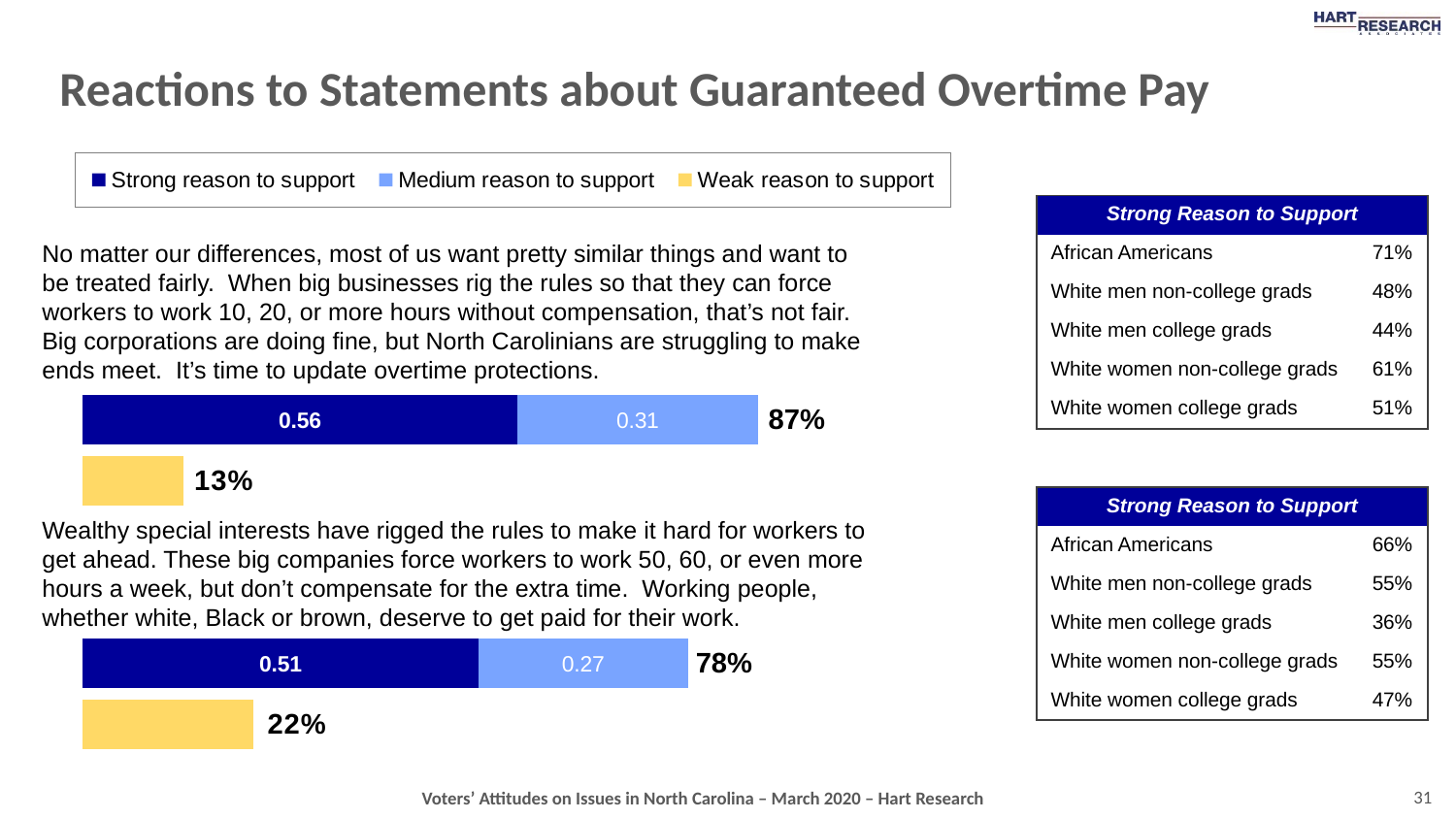
In the upper bar chart (first statement), what total percentage is printed at the end of the stacked strong/medium bar? 87% In the upper bar chart (first statement), what value is printed on the light blue 'Medium reason to support' segment? 0.31 How many series does the legend at the top of the slide list? 3 In the lower bar chart (second statement), what value is printed on the dark blue 'Strong reason to support' segment? 0.51 What kind of chart is used to show the reactions to each statement? stacked bar chart In the lower bar chart (second statement), what percentage is shown next to the yellow 'Weak reason to support' bar? 22% In the lower bar chart (second statement), what total percentage is printed at the end of the stacked strong/medium bar? 78% Which chart has the larger 'Strong reason to support' value, the upper chart (0.56) or the lower chart (0.51)? the upper chart What is the difference between the 'Strong reason to support' values of the upper chart (0.56) and the lower chart (0.51)? 0.05 In the upper bar chart (first statement), what value is printed on the dark blue 'Strong reason to support' segment? 0.56 In the lower bar chart (second statement), what value is printed on the light blue 'Medium reason to support' segment? 0.27 In the upper bar chart (first statement), what percentage is shown next to the yellow 'Weak reason to support' bar? 13%